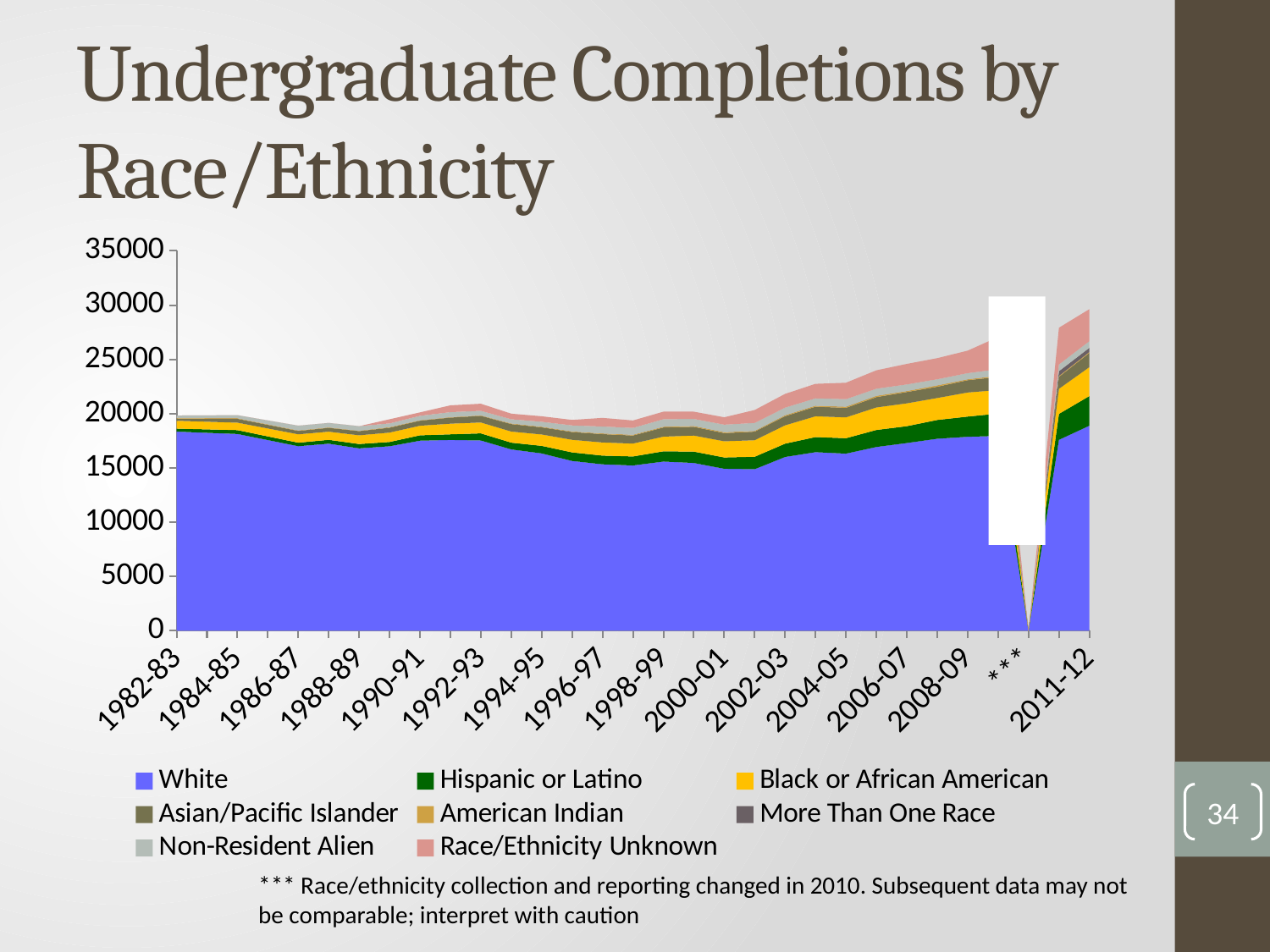
Is the total of all series in 2011-12 greater or less than 25000? greater How many series does the legend list? 8 Is the value for White in 2002-03 greater or less than 20000? less Does the value for White rise or fall from 1982-83 to 2002-03? Fall What is the title of the chart? Undergraduate Completions by Race/Ethnicity Which series has the largest value in 2011-12, White or Hispanic or Latino? White What kind of chart is shown on the slide? Stacked area chart Which series is shown in blue in the legend? White What is the highest value shown on the vertical axis? 35000 Which series accounts for the largest share of completions across the years shown? White Is the value for White in 1982-83 greater or less than 15000? greater